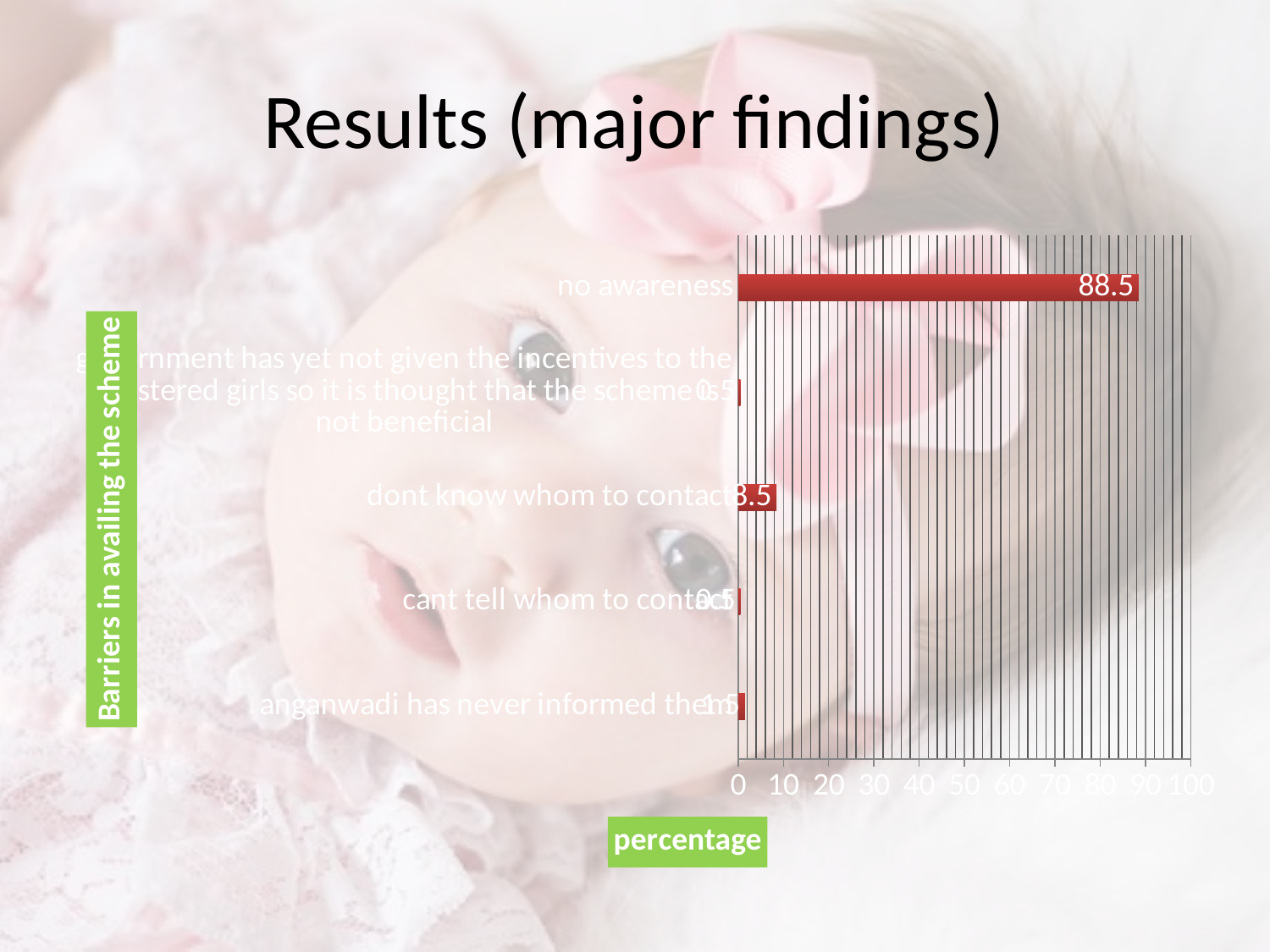
Which is larger, the value for "dont know whom to contact" or "anganwadi has never informed them"? dont know whom to contact What is the difference between the percentage for "no awareness" and "dont know whom to contact"? 80 Which barrier has the highest percentage? no awareness What is the percentage value for "cant tell whom to contact"? 0.5 What is the percentage value for "no awareness"? 88.5 Is the value for "dont know whom to contact" greater or less than 10? less What is the percentage value for "anganwadi has never informed them"? 1.5 What is the title of the horizontal axis of the chart? percentage Is the value for "no awareness" greater or less than 80? greater How many barrier categories are shown in the chart? 5 What kind of chart is shown on the slide? bar chart What is the percentage value for "dont know whom to contact"? 8.5